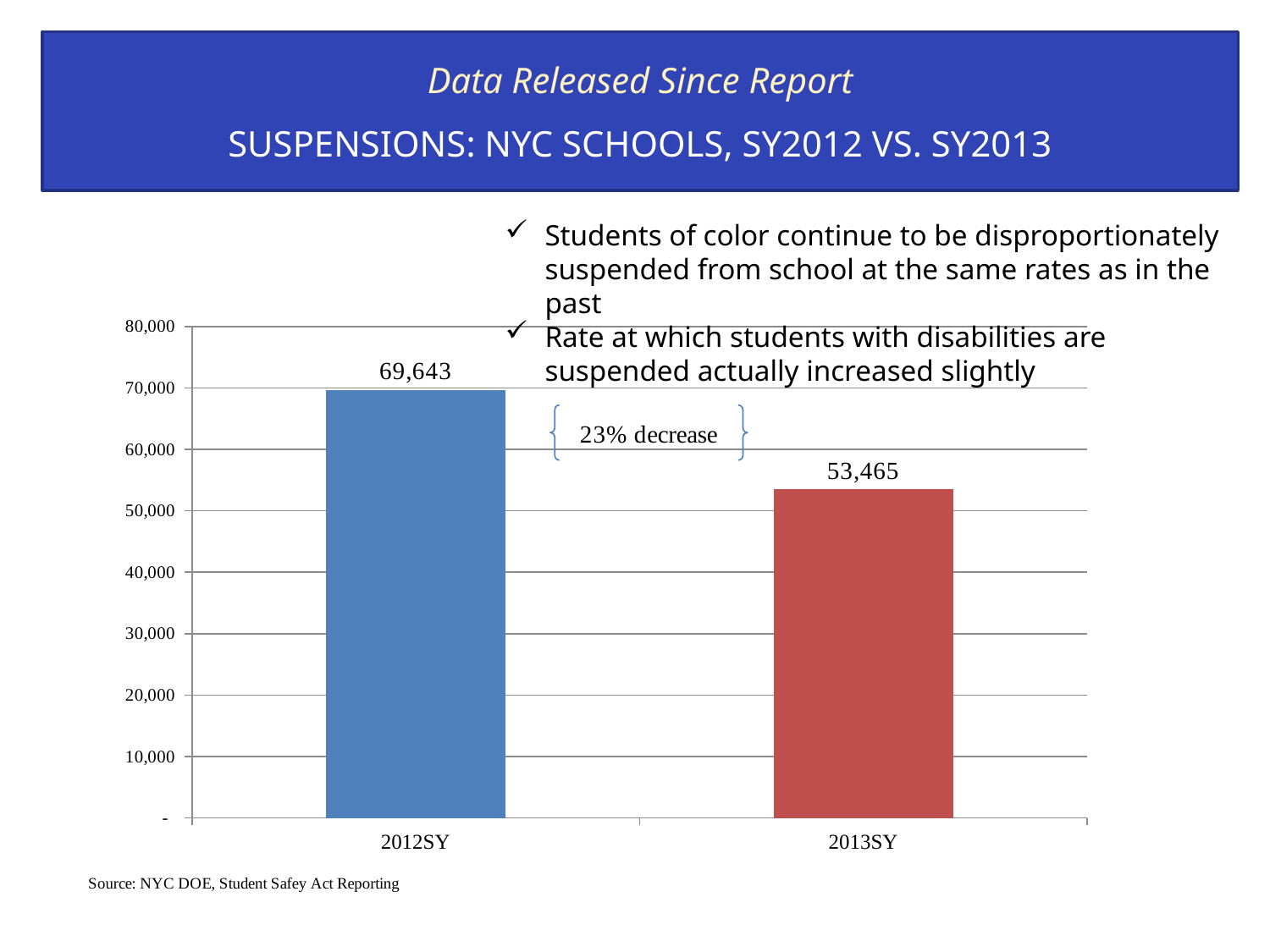
What colour is the bar for 2013SY? red Is the value for 2012SY greater or less than 60,000? greater Which school year has the higher number of suspensions? 2012SY Is the value for 2013SY greater or less than 60,000? less What percentage change is annotated between the two bars? 23% decrease Do the values rise or fall from 2012SY to 2013SY? fall How many categories are shown on the x axis of the chart? 2 What is the number of suspensions shown for 2013SY? 53,465 What is the number of suspensions shown for 2012SY? 69,643 What is the difference between the 2012SY and 2013SY suspension values? 16,178 What kind of chart is shown on the slide? bar chart Which school year has the lower number of suspensions? 2013SY